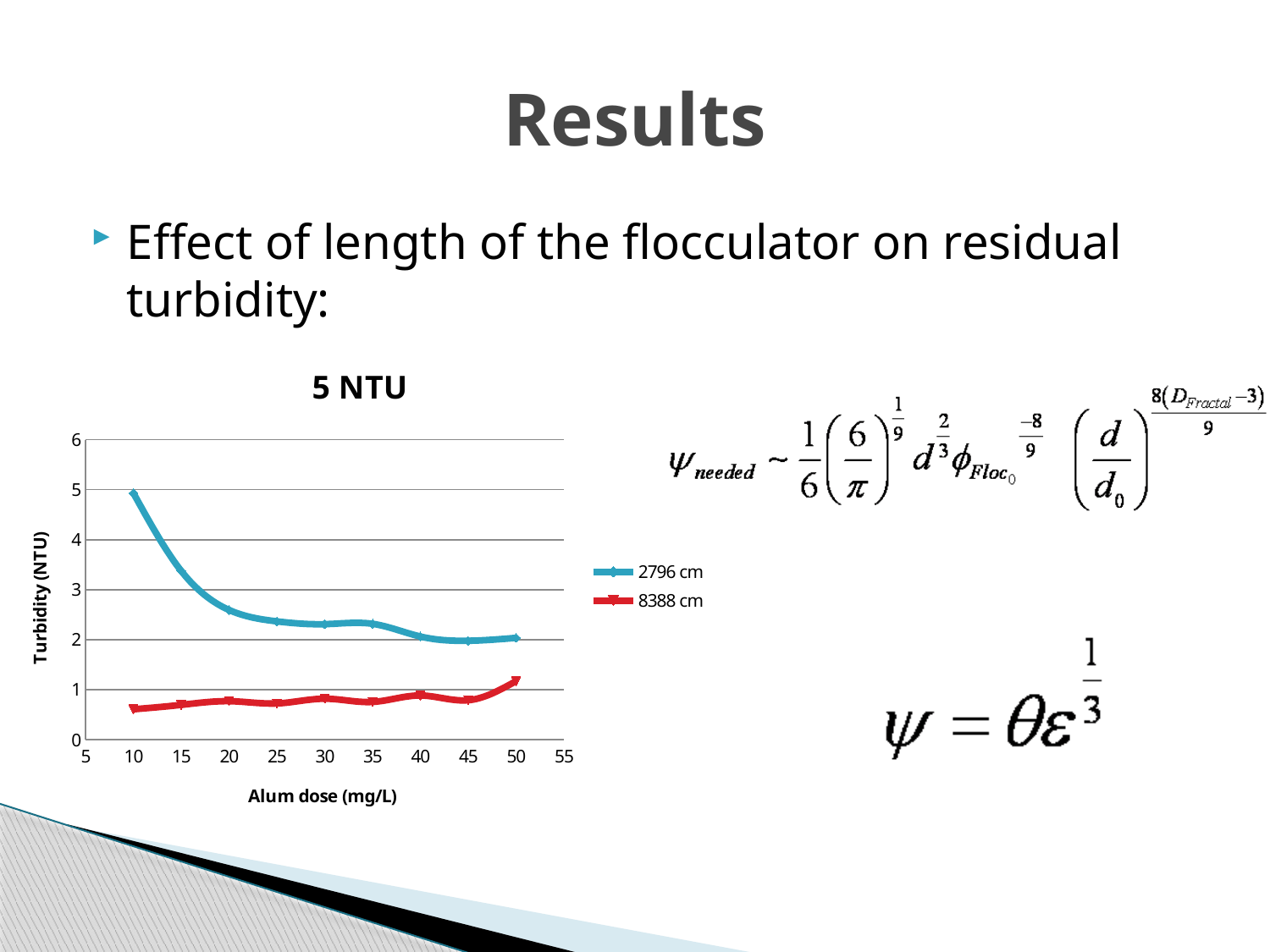
What is the title of the chart? 5 NTU Is the turbidity for the 2796 cm series at an alum dose of 20 mg/L greater or less than 2? greater At an alum dose of 30 mg/L, which series has the higher turbidity, 2796 cm or 8388 cm? 2796 cm How many series does the legend of the 5 NTU chart list? 2 What kind of chart is shown on the slide? line chart Is the turbidity for the 8388 cm series at an alum dose of 30 mg/L greater or less than 2? less At which alum dose does the 2796 cm series reach its highest turbidity? 10 Is the turbidity for the 2796 cm series at an alum dose of 10 mg/L greater or less than 4? greater What are the two series named in the legend of the 5 NTU chart? 2796 cm and 8388 cm Does the turbidity for the 2796 cm series generally rise or fall as the alum dose increases from 10 to 45 mg/L? fall How many data points are plotted for the 2796 cm series? 9